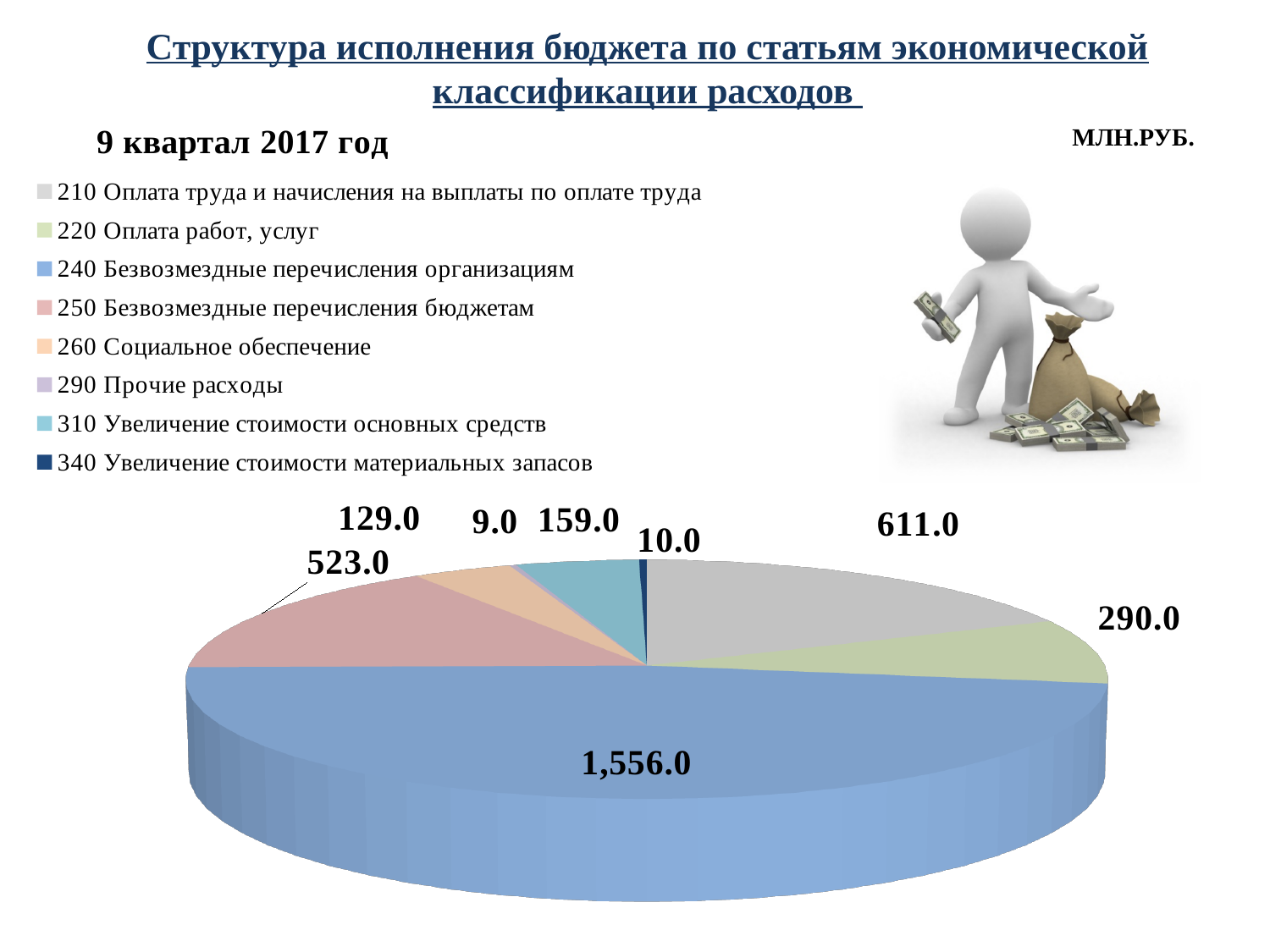
What is the total of all the slices in the pie? 3,287.0 Which category has the smallest slice of the pie? 290 Прочие расходы What is the value for 240 Безвозмездные перечисления организациям? 1,556.0 What is the value for 310 Увеличение стоимости основных средств? 159.0 What is the difference between the values for 210 Оплата труда и начисления на выплаты по оплате труда and 220 Оплата работ, услуг? 321.0 How many categories does the legend list? 8 Which is larger: the value for 260 Социальное обеспечение or the value for 310 Увеличение стоимости основных средств? 310 Увеличение стоимости основных средств What is the value for 210 Оплата труда и начисления на выплаты по оплате труда? 611.0 What is the value for 250 Безвозмездные перечисления бюджетам? 523.0 What kind of chart is shown on the slide? Pie chart What unit of measurement is indicated on the slide for the chart values? МЛН.РУБ. Which category has the largest slice of the pie? 240 Безвозмездные перечисления организациям